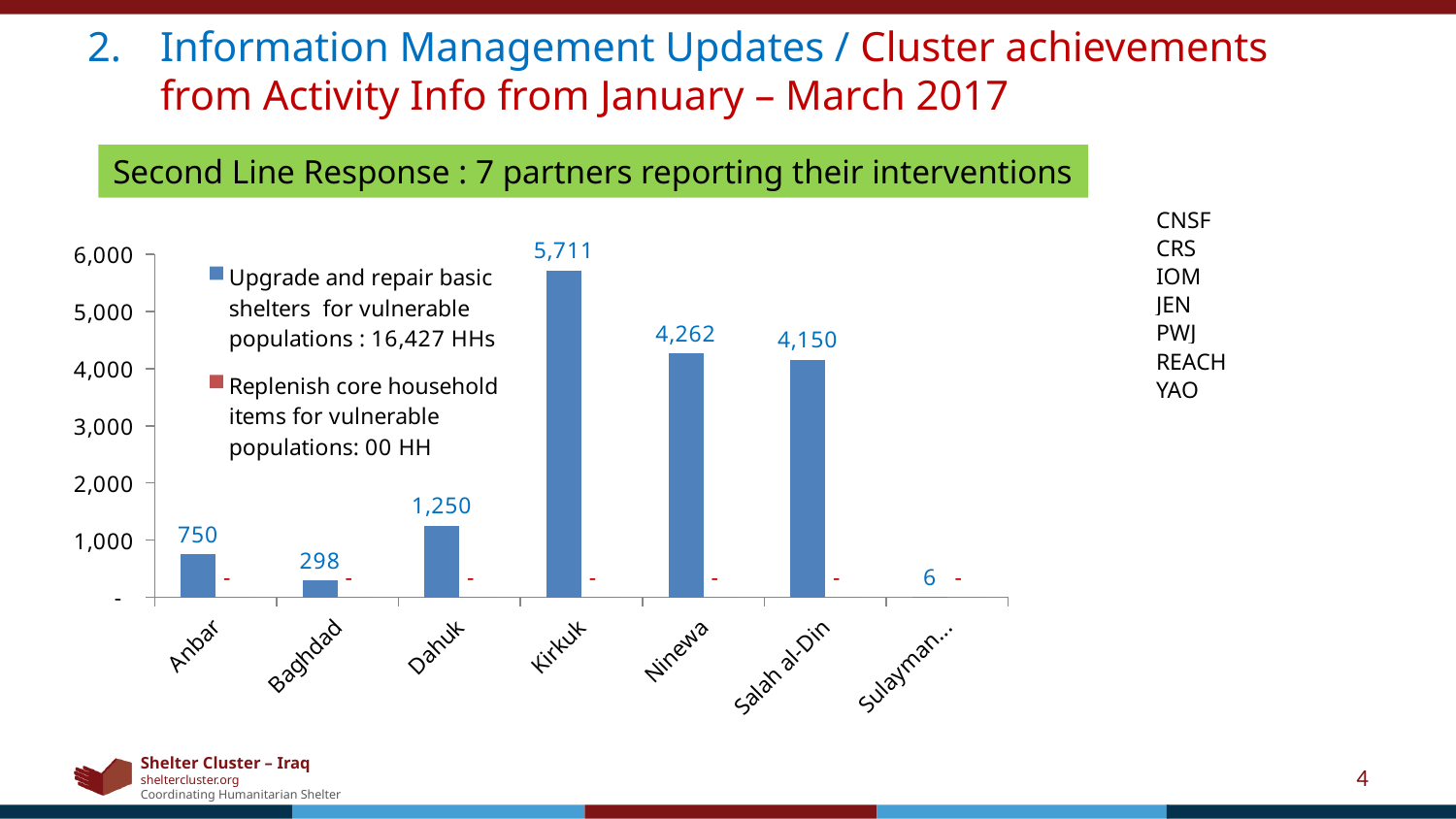
Which has a larger value for upgrade and repair of basic shelters, Anbar or Baghdad? Anbar Is the value for Ninewa in the 'Upgrade and repair basic shelters' series greater or less than 4,000? greater What is the value for Dahuk in the 'Upgrade and repair basic shelters' series? 1,250 How many series does the chart legend list? 2 What is the difference between the values for Ninewa and Salah al-Din in the 'Upgrade and repair basic shelters' series? 112 Which governorate has the lowest value for upgrade and repair of basic shelters? Sulayman... Which governorate has the highest value for upgrade and repair of basic shelters? Kirkuk What is the value for Kirkuk in the 'Upgrade and repair basic shelters' series? 5,711 How many governorates are shown on the x axis of the chart? 7 What total number of households does the legend give for the 'Upgrade and repair basic shelters for vulnerable populations' series? 16,427 HHs What is the value for Anbar in the 'Upgrade and repair basic shelters' series? 750 What kind of chart is shown on the slide? Bar chart